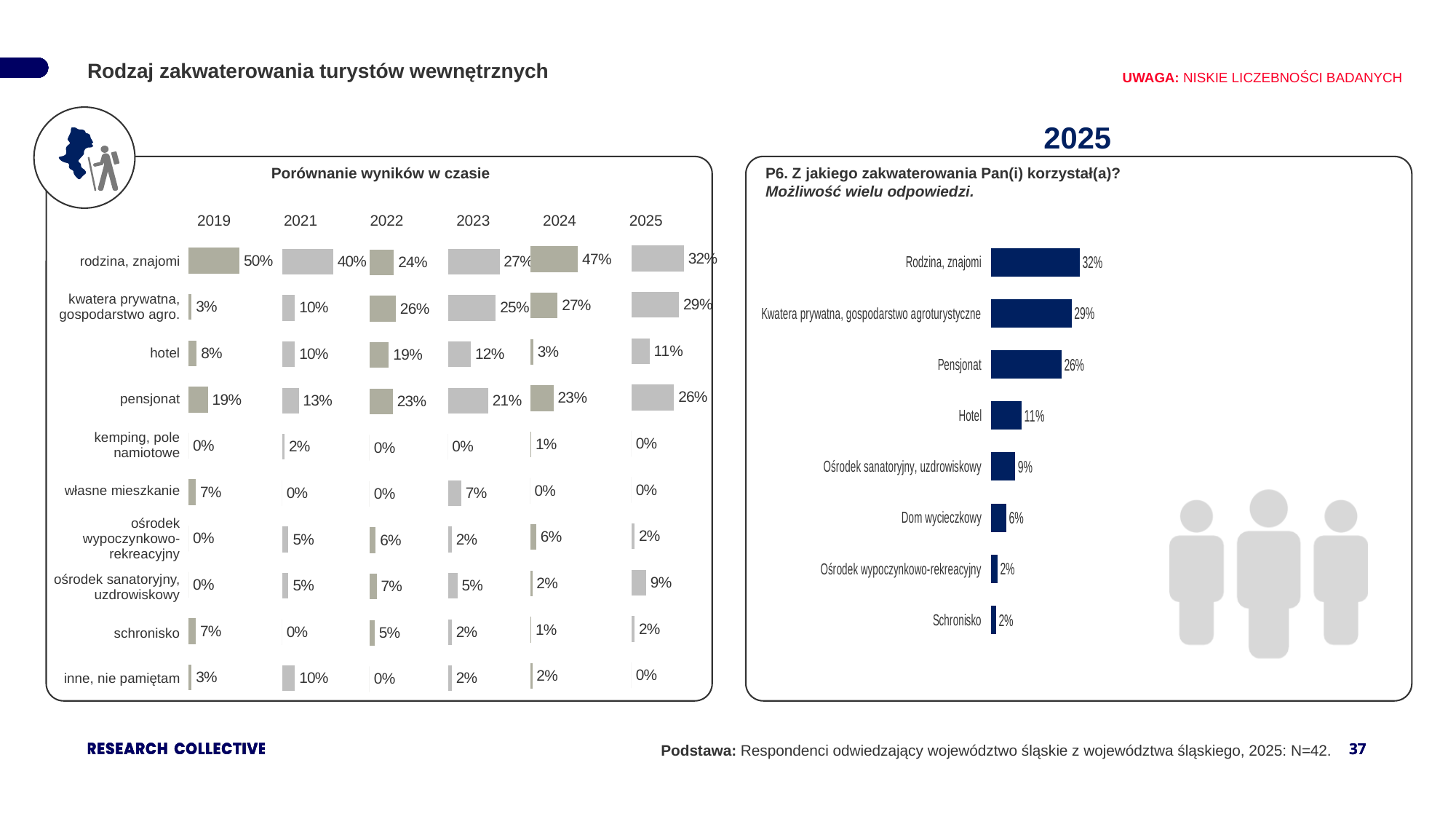
In the chart 'Porównanie wyników w czasie', what is the value for hotel in 2022? 19% In the chart 'Porównanie wyników w czasie', what is the value for rodzina, znajomi in 2019? 50% In the 2025 chart on the right, what is the difference between Rodzina, znajomi and Kwatera prywatna, gospodarstwo agroturystyczne? 3% How many categories are shown in the 2025 chart on the right? 8 How many years are compared in the chart 'Porównanie wyników w czasie'? 6 In the chart 'Porównanie wyników w czasie', is the value for pensjonat higher in 2024 or in 2025? 2025 In the chart 'Porównanie wyników w czasie', in which year is the value for rodzina, znajomi the highest? 2019 In the 2025 chart on the right, what is the value for Dom wycieczkowy? 6% What kind of chart is the 2025 chart on the right? bar chart In the chart 'Porównanie wyników w czasie', what is the difference between the 2025 and 2019 values for kwatera prywatna, gospodarstwo agro.? 26% In the 2025 chart on the right, what is the value for Pensjonat? 26% In the 2025 chart on the right, which category has the highest value? Rodzina, znajomi